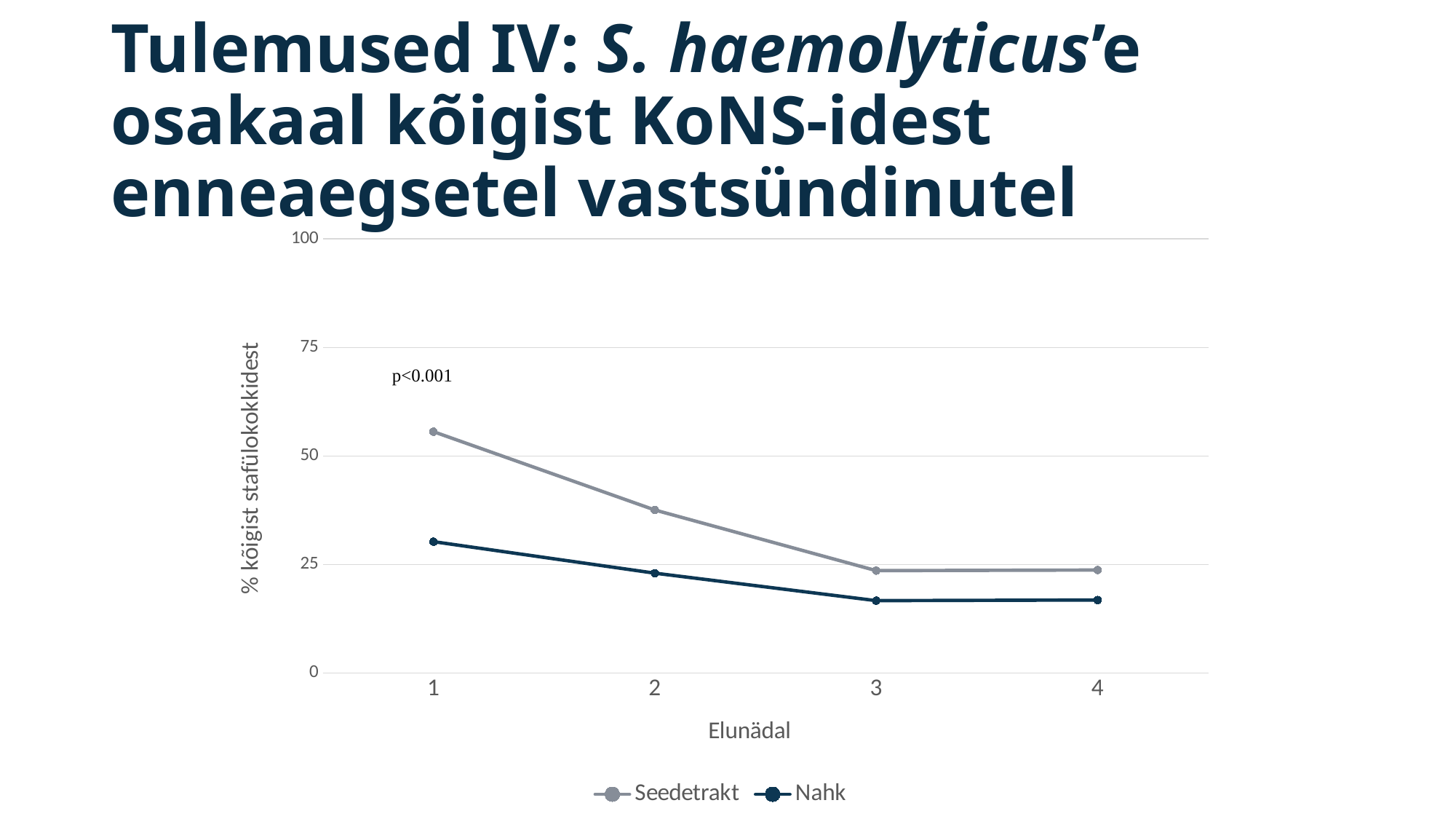
Is the value for Seedetrakt at Elunädal 1 greater or less than 50? greater What kind of chart is shown on the slide? line chart How many points along the x axis (Elunädal) are plotted for each series? 4 Is the value for Seedetrakt at Elunädal 2 greater or less than 50? less At which Elunädal is the Seedetrakt series highest? 1 Do the values for Nahk rise or fall from Elunädal 1 to Elunädal 3? fall What are the two series named in the legend? Seedetrakt and Nahk Is the value for Nahk at Elunädal 1 greater or less than 50? less What is the title of the x axis? Elunädal How many series does the legend list? 2 Which series has the larger value at Elunädal 1, Seedetrakt or Nahk? Seedetrakt